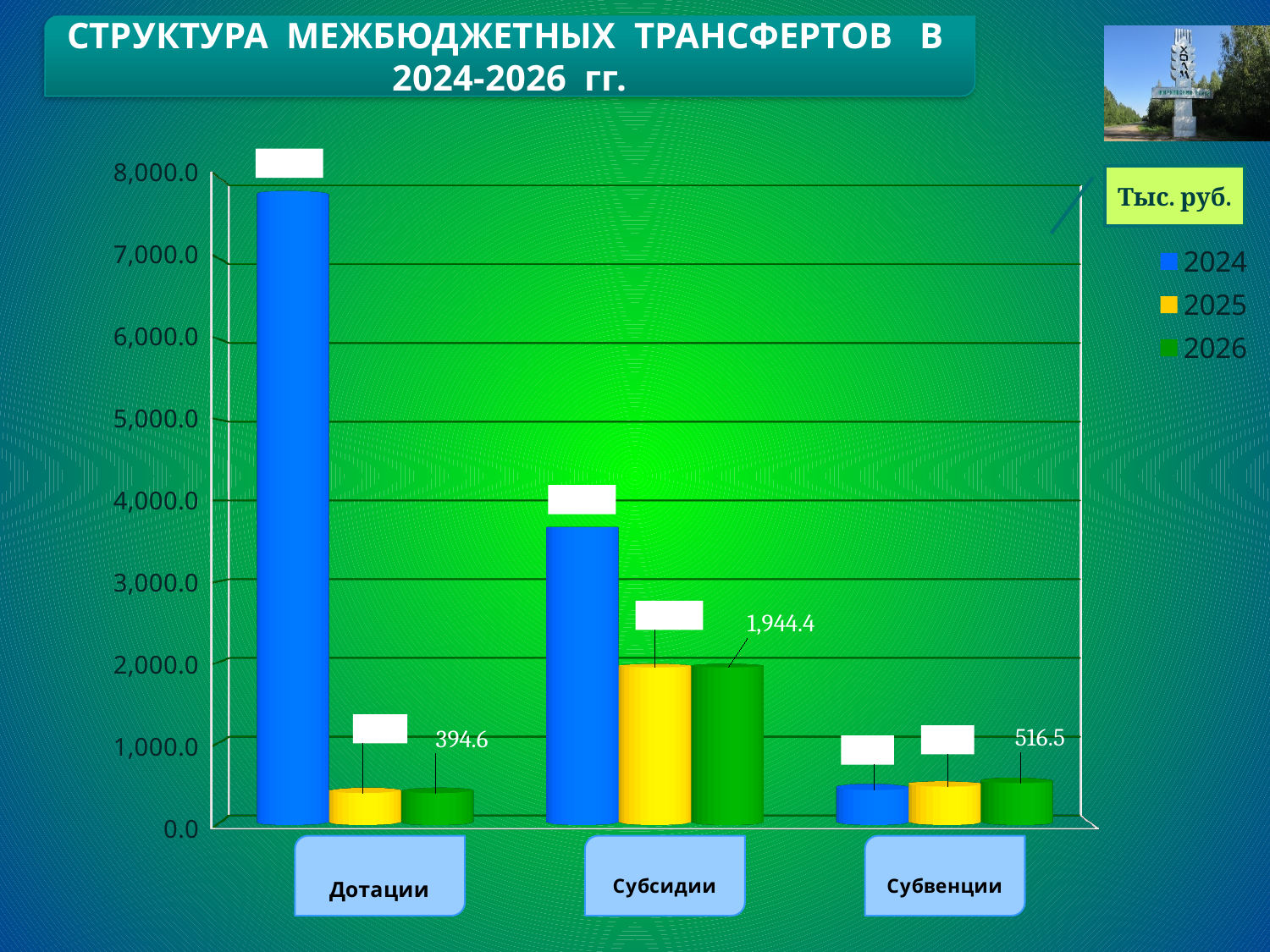
Is the 2024 value for Дотации greater or less than 7,000.0? greater Which category has the highest value for the 2026 series? Субсидии What is the difference between the 2026 values for Субсидии and Дотации? 1,549.8 How many series does the legend list? 3 Which category has the lowest value for the 2026 series? Дотации What is the value for 2026 in the Субсидии category? 1,944.4 Which is larger: the 2024 value for Дотации or the 2024 value for Субсидии? Дотации Is the 2024 value for Субвенции greater or less than 1,000.0? less What kind of chart is shown on the slide? Bar chart What is the value for 2026 in the Субвенции category? 516.5 How many categories are shown on the x axis? 3 What is the value for 2026 in the Дотации category? 394.6